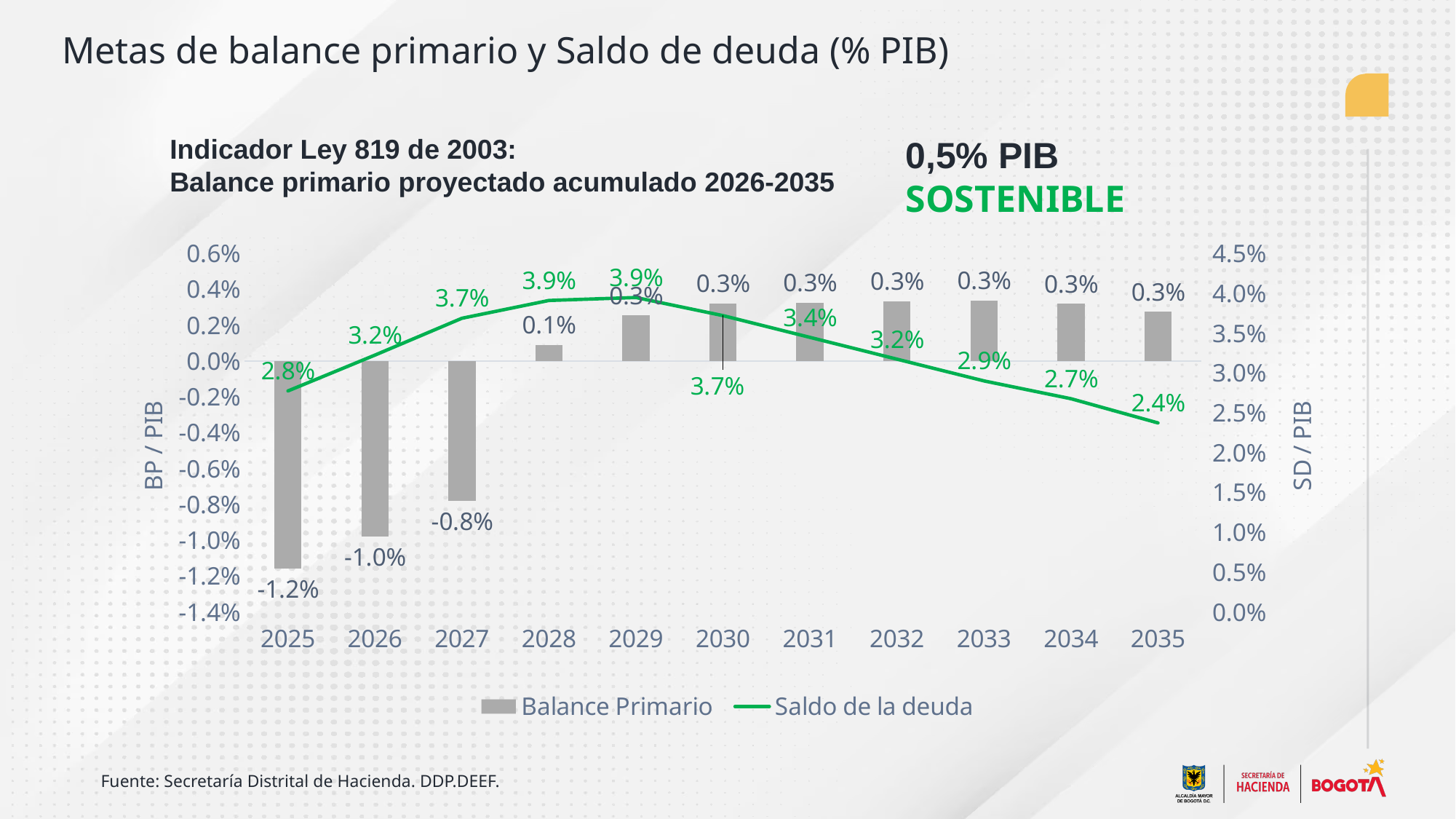
What kind of chart is shown on the slide? Combined bar and line chart What is the Saldo de la deuda value for 2035? 2.4% Which year has the lowest Balance Primario value? 2025 What is the Saldo de la deuda value for 2028? 3.9% How many series does the legend list? 2 What is the Balance Primario value for 2028? 0.1% Does the Saldo de la deuda line rise or fall from 2029 to 2035? Fall Which is larger, the Balance Primario value for 2026 or for 2027? 2027 How many years are shown on the x axis? 11 What is the difference between the Saldo de la deuda values for 2027 and 2035? 1.3% What is the Balance Primario value for 2025? -1.2% Which year has the lowest Saldo de la deuda value? 2035